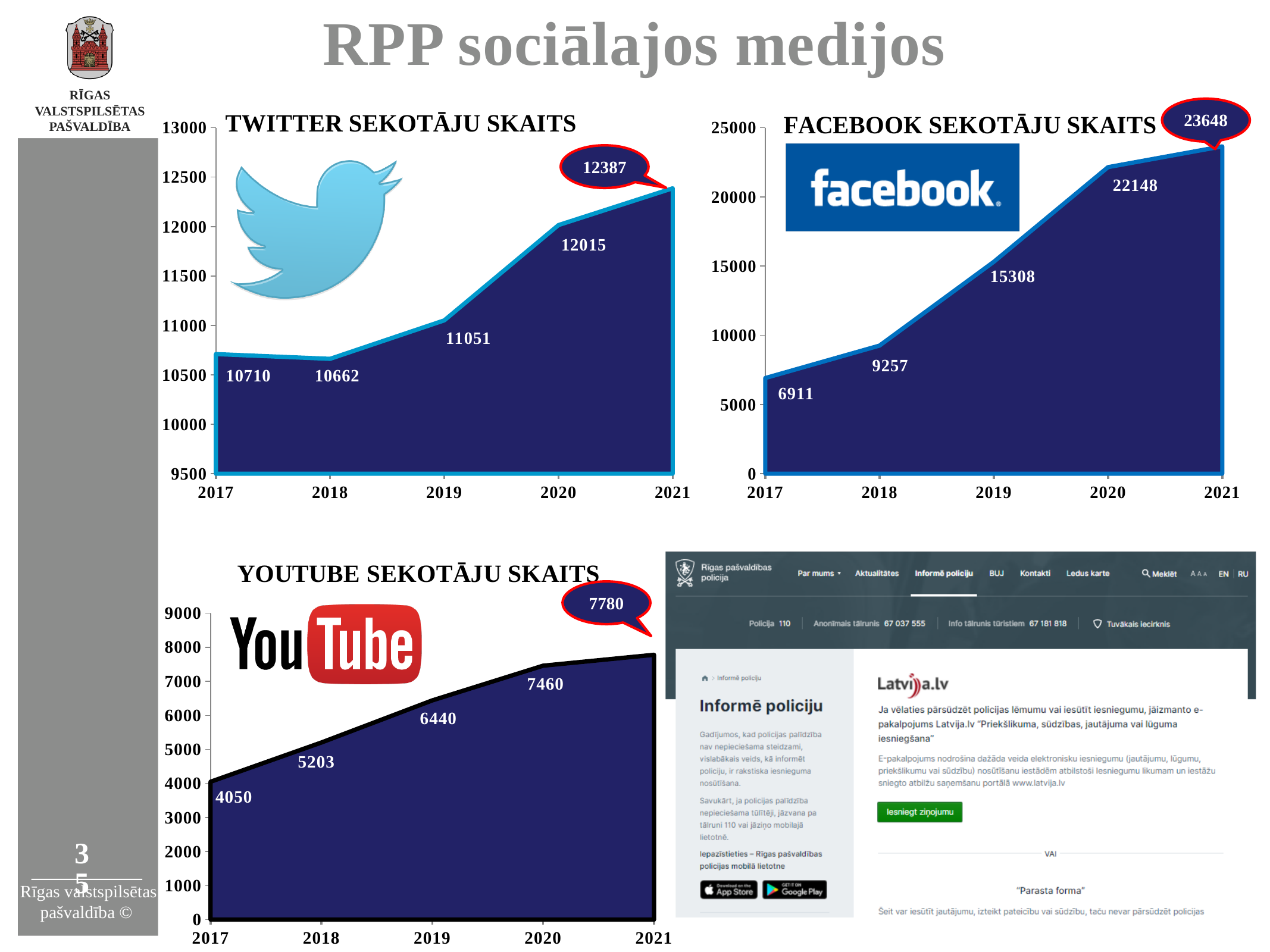
What kind of chart is the FACEBOOK SEKOTĀJU SKAITS chart? area chart In the YOUTUBE SEKOTĀJU SKAITS chart, do the values rise or fall from 2017 to 2021? rise In the TWITTER SEKOTĀJU SKAITS chart, which year has the lowest value? 2018 In the FACEBOOK SEKOTĀJU SKAITS chart, what is the value for 2018? 9257 In the TWITTER SEKOTĀJU SKAITS chart, which is larger, the value for 2017 or the value for 2018? 2017 In the TWITTER SEKOTĀJU SKAITS chart, what is the value for 2019? 11051 In the FACEBOOK SEKOTĀJU SKAITS chart, which year has the highest value? 2021 How many years are plotted in the YOUTUBE SEKOTĀJU SKAITS chart? 5 In the FACEBOOK SEKOTĀJU SKAITS chart, is the value for 2019 greater or less than 15000? greater In the YOUTUBE SEKOTĀJU SKAITS chart, what is the value for 2020? 7460 In the YOUTUBE SEKOTĀJU SKAITS chart, what is the difference between the 2021 and 2017 values? 3730 In the FACEBOOK SEKOTĀJU SKAITS chart, what is the difference between the 2020 and 2019 values? 6840